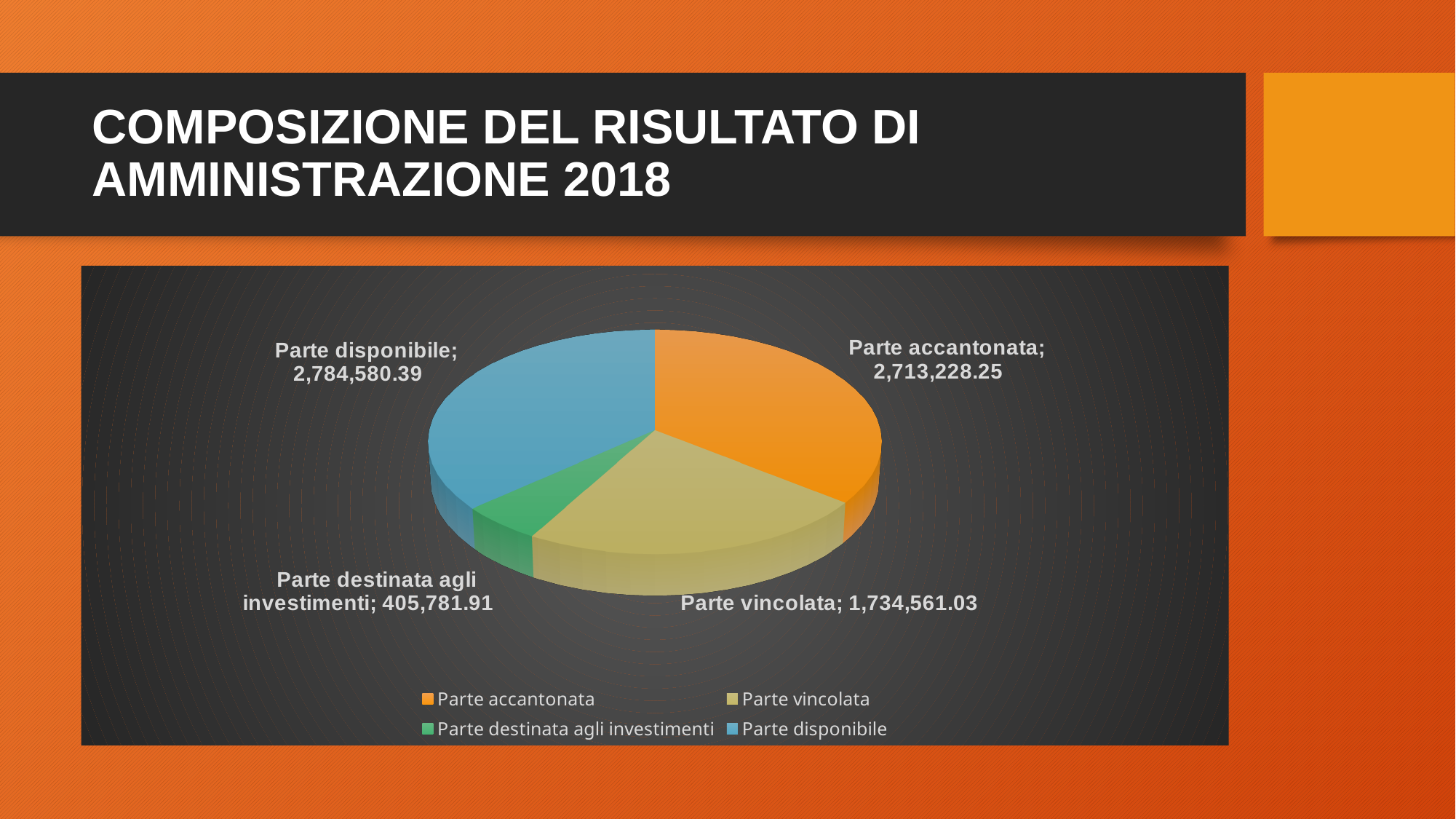
Which slice has the lowest value? Parte destinata agli investimenti What kind of chart is shown on the slide? Pie chart Which is larger, Parte accantonata or Parte vincolata? Parte accantonata What is the difference between Parte disponibile and Parte accantonata? 71,352.14 What is the value for Parte vincolata? 1,734,561.03 What is the value for Parte disponibile? 2,784,580.39 What is the difference between Parte accantonata and Parte vincolata? 978,667.22 What colour is the Parte disponibile slice? Blue How many slices does the pie chart have? 4 Which slice has the highest value? Parte disponibile What is the value for Parte accantonata? 2,713,228.25 What is the value for Parte destinata agli investimenti? 405,781.91